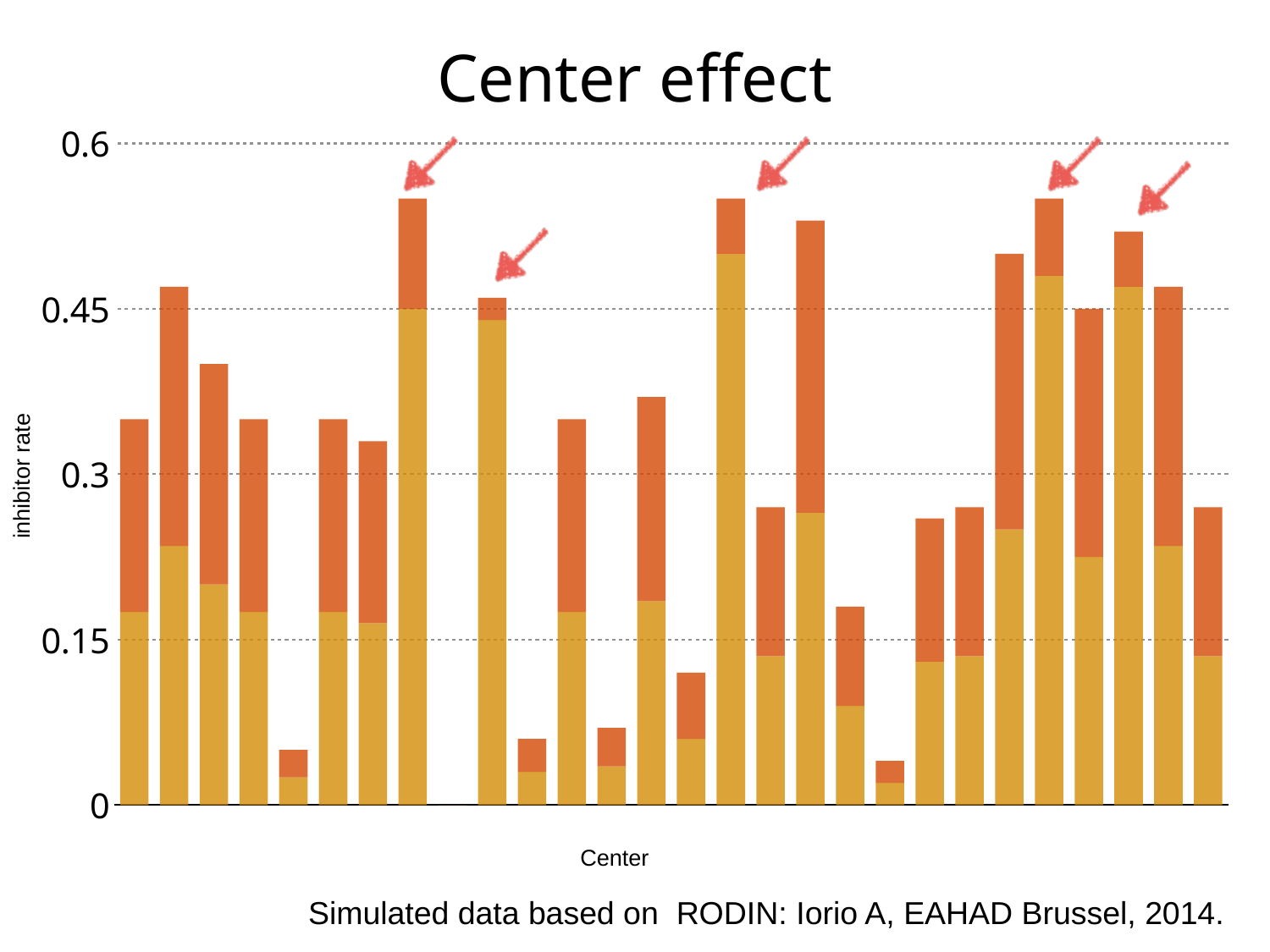
What kind of chart is shown on the slide? Stacked bar chart Is the value of the tallest bar greater or less than 0.45? greater Is the value of the shortest bar greater or less than 0.15? less How many bars are plotted in the chart? 27 What is the label on the vertical axis of the chart? inhibitor rate What is the highest value shown on the vertical axis? 0.6 Is the value of the tallest bar greater or less than 0.6? less What is the title of the chart? Center effect How many coloured segments make up each stacked bar? 2 What is the lowest value shown on the vertical axis? 0